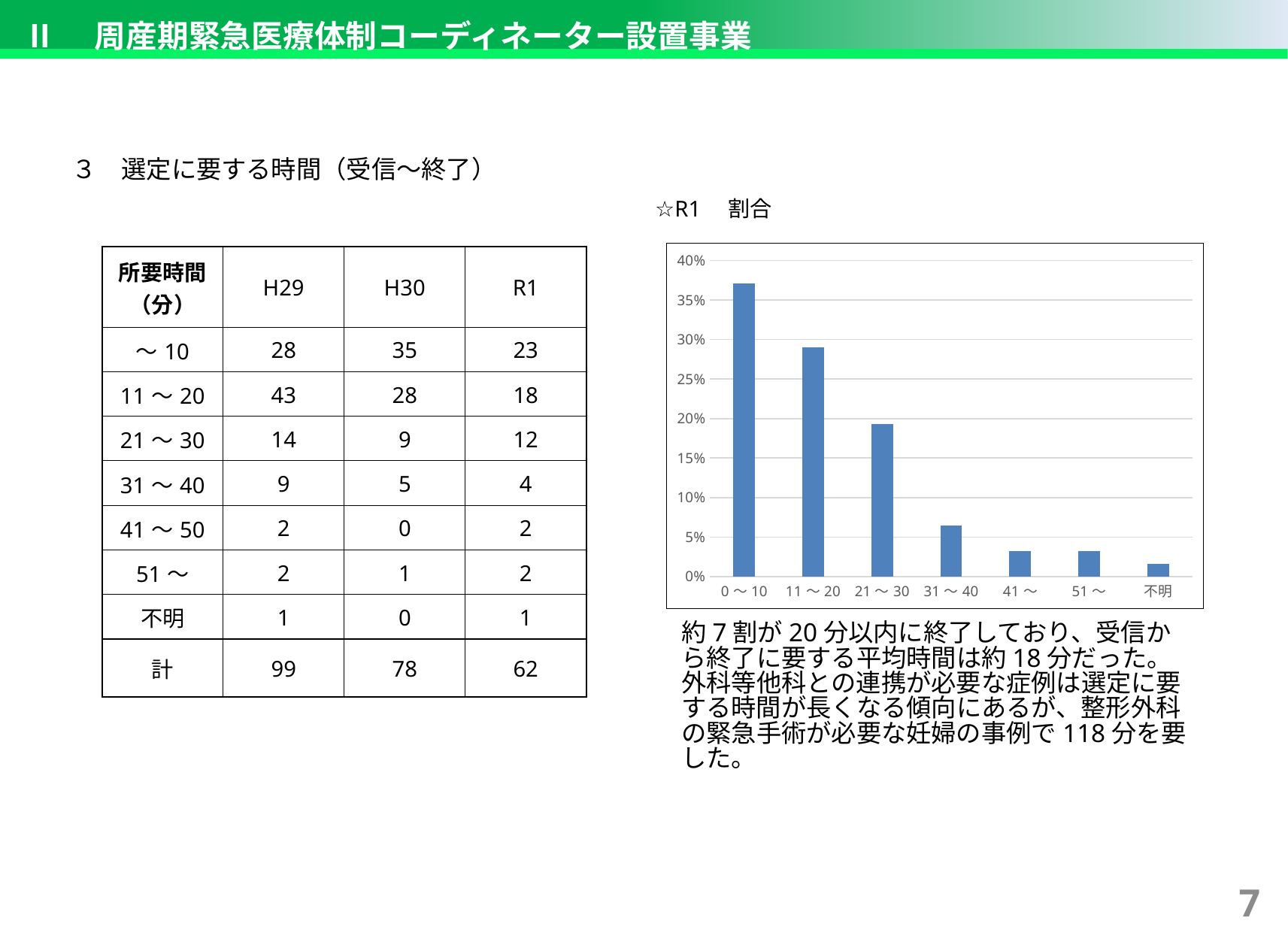
Is the value for 31 ～ 40 greater or less than 10%? less Which category has the highest bar in the chart? 0 ～ 10 What is the title shown above the chart? ☆R1 割合 What kind of chart is shown on the slide? bar chart Is the value for 11 ～ 20 greater or less than 30%? less Which is larger, the value for 11 ～ 20 or the value for 21 ～ 30? 11 ～ 20 How many categories are plotted on the x axis of the chart? 7 Do the bar values generally rise or fall from left to right along the x axis? fall Is the value for 0 ～ 10 greater or less than 35%? greater Which category has the lowest bar in the chart? 不明